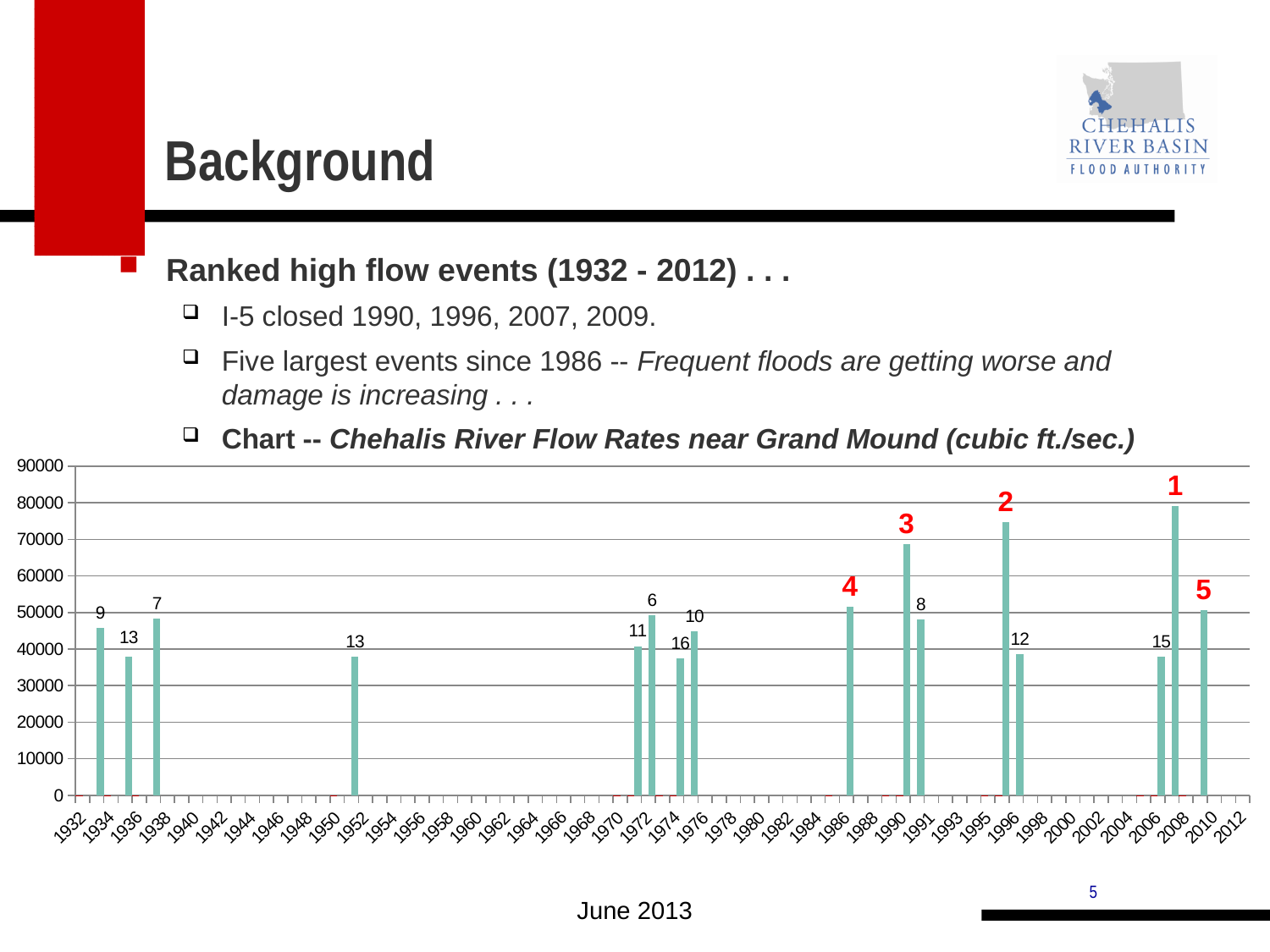
How many bars in the chart have their rank label printed in red? 5 Is the value of the bar labeled 6 greater or less than 40000? greater What kind of chart is shown on the slide? bar chart Is the value of the bar labeled 4 greater or less than 60000? less Is the value of the bar labeled 3 greater or less than 60000? greater Which rank label marks the tallest bar in the chart? 1 How many bars (high flow events) are plotted in the chart? 16 Which is larger, the bar labeled 3 or the bar labeled 4? the bar labeled 3 What is the title of the chart on the slide? Chehalis River Flow Rates near Grand Mound (cubic ft./sec.)